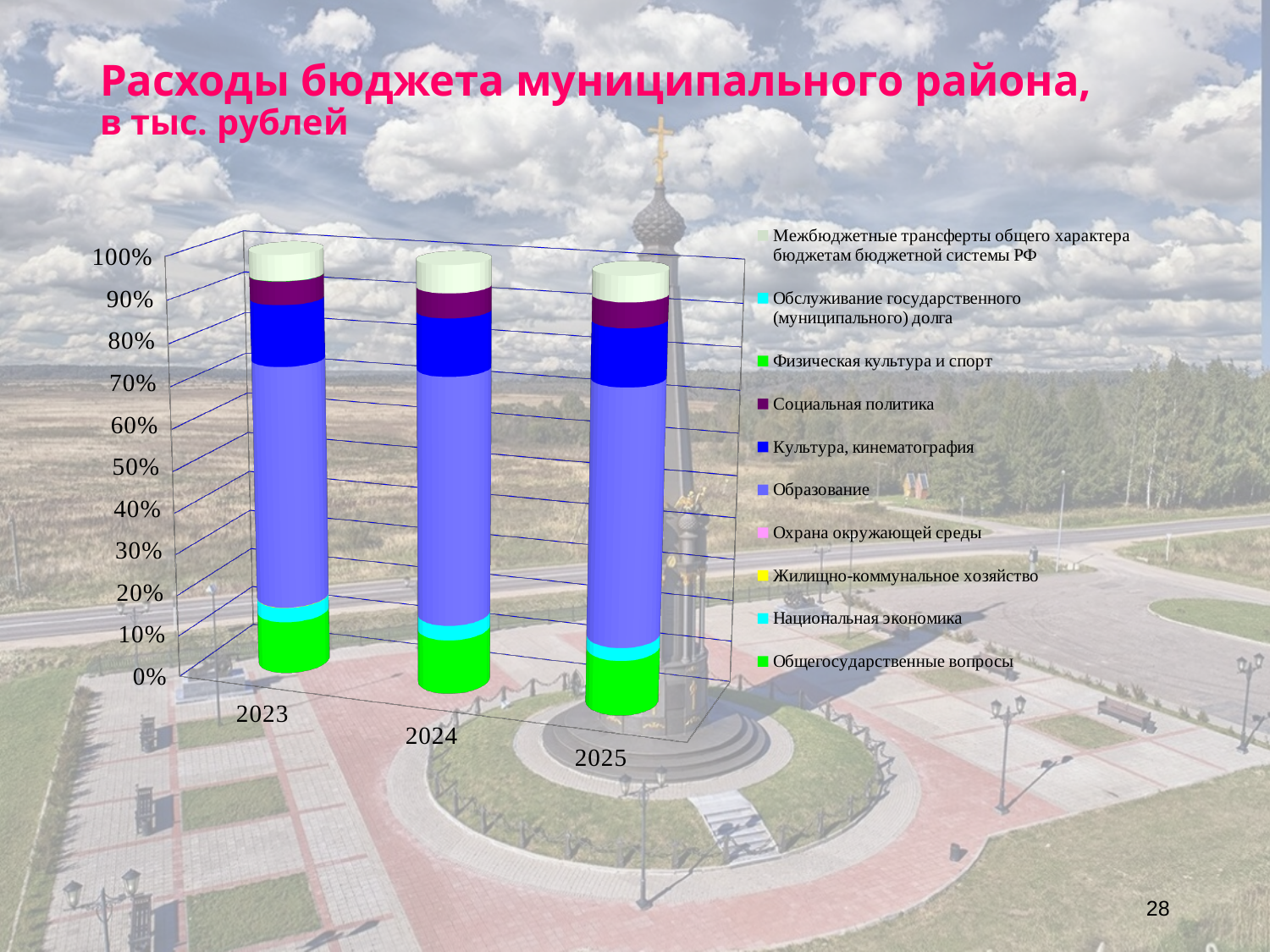
Which series occupies the largest share of the 2025 bar? Образование What kind of chart is shown on the slide? Stacked bar chart What is the highest value shown on the chart's vertical axis? 100% Is the share of Общегосударственные вопросы in the 2023 bar greater or less than 30%? less Which series occupies the largest share of the 2023 bar? Образование How many series does the chart legend list? 10 In the 2023 bar, which segment is larger: Культура, кинематография or Социальная политика? Культура, кинематография Which years are listed along the x axis of the chart? 2023, 2024, 2025 Is the share of Образование in the 2023 bar greater or less than 30%? greater What is the title of the chart on the slide? Расходы бюджета муниципального района, в тыс. рублей In the 2024 bar, which segment is larger: Образование or Общегосударственные вопросы? Образование How many years (categories) are shown on the x axis of the chart? 3